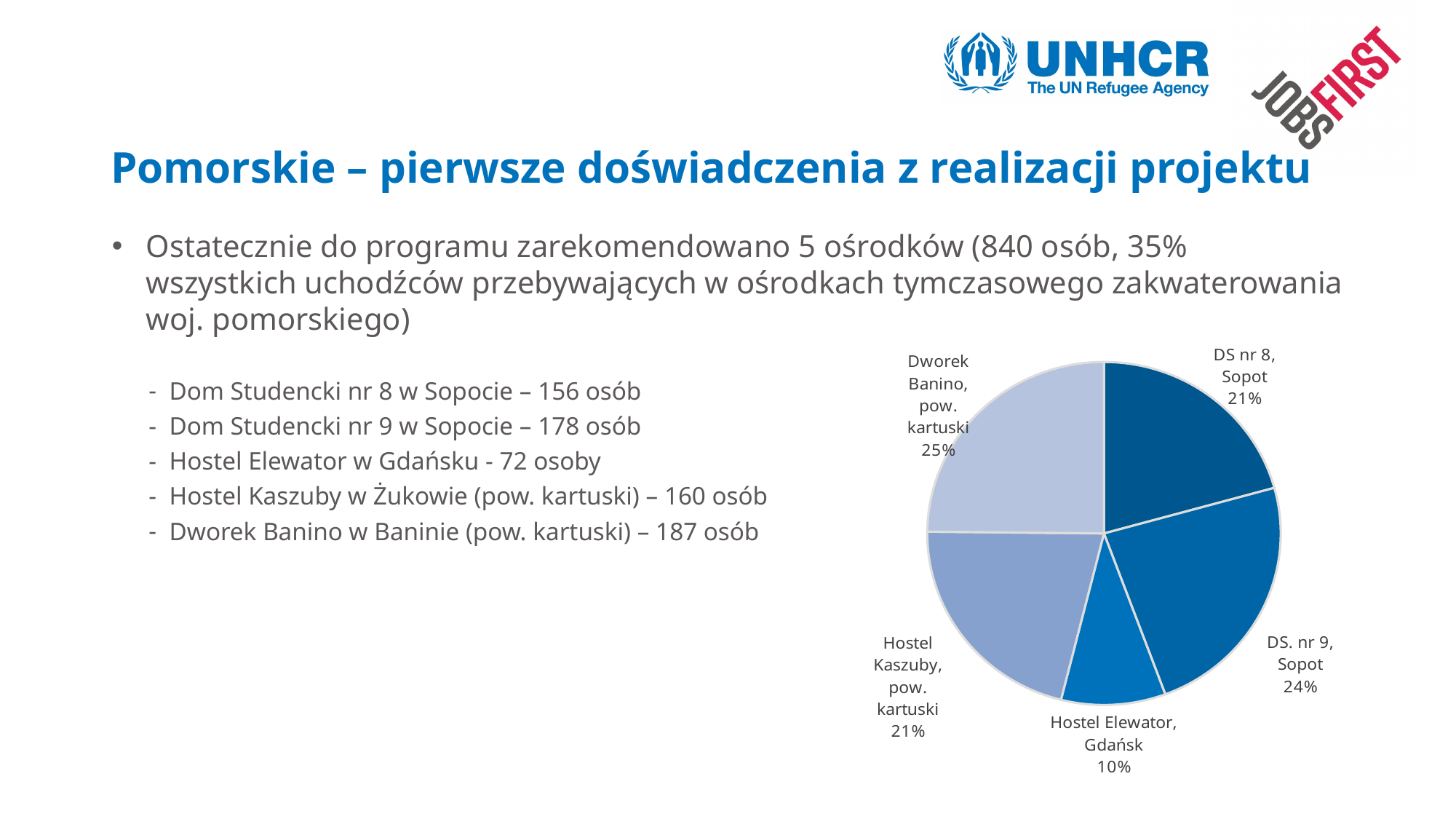
Which slice is larger: DS. nr 9, Sopot or Hostel Elewator, Gdańsk? DS. nr 9, Sopot What share of the pie does DS. nr 9, Sopot have? 24% What is the difference in percentage points between the Dworek Banino slice and the Hostel Elewator slice? 15 Which slice of the pie chart is the largest? Dworek Banino, pow. kartuski Which slice of the pie chart is shown in the lightest blue colour? Dworek Banino, pow. kartuski How many slices does the pie chart have? 5 Which slice of the pie chart is the smallest? Hostel Elewator, Gdańsk What share of the pie does Hostel Kaszuby, pow. kartuski have? 21% What kind of chart is shown on the slide? pie chart What share of the pie does Dworek Banino, pow. kartuski have? 25%